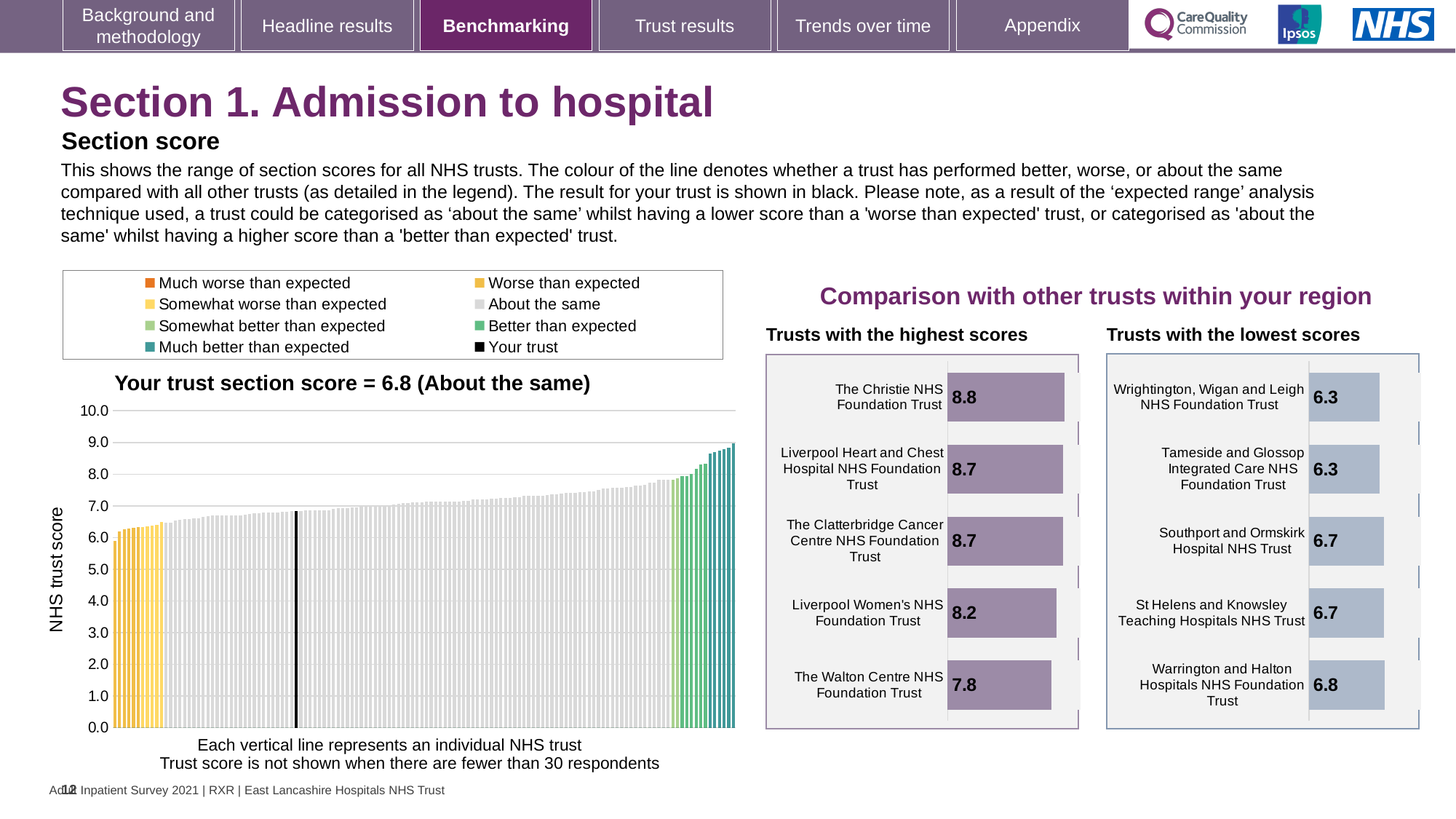
In the 'Trusts with the lowest scores' chart, what is the score for Warrington and Halton Hospitals NHS Foundation Trust? 6.8 In the 'Trusts with the highest scores' chart, what is the difference between the scores of The Christie NHS Foundation Trust and The Walton Centre NHS Foundation Trust? 1.0 In the 'Trusts with the lowest scores' chart, what is the score for Southport and Ormskirk Hospital NHS Trust? 6.7 In the 'Trusts with the highest scores' chart, which trust has the highest score? The Christie NHS Foundation Trust In the 'Trusts with the highest scores' chart, which trust has the lowest score? The Walton Centre NHS Foundation Trust How many entries does the legend above the 'Your trust section score' chart list? 8 In the 'Your trust section score' chart, what is the section score for your trust? 6.8 How many trusts are shown in the 'Trusts with the lowest scores' chart? 5 In the 'Trusts with the lowest scores' chart, what is the difference between the scores of Warrington and Halton Hospitals NHS Foundation Trust and Tameside and Glossop Integrated Care NHS Foundation Trust? 0.5 In the 'Trusts with the highest scores' chart, what is the score for The Walton Centre NHS Foundation Trust? 7.8 In the 'Trusts with the highest scores' chart, what is the score for The Christie NHS Foundation Trust? 8.8 In the 'Trusts with the highest scores' chart, which has the larger score: Liverpool Women's NHS Foundation Trust or The Walton Centre NHS Foundation Trust? Liverpool Women's NHS Foundation Trust